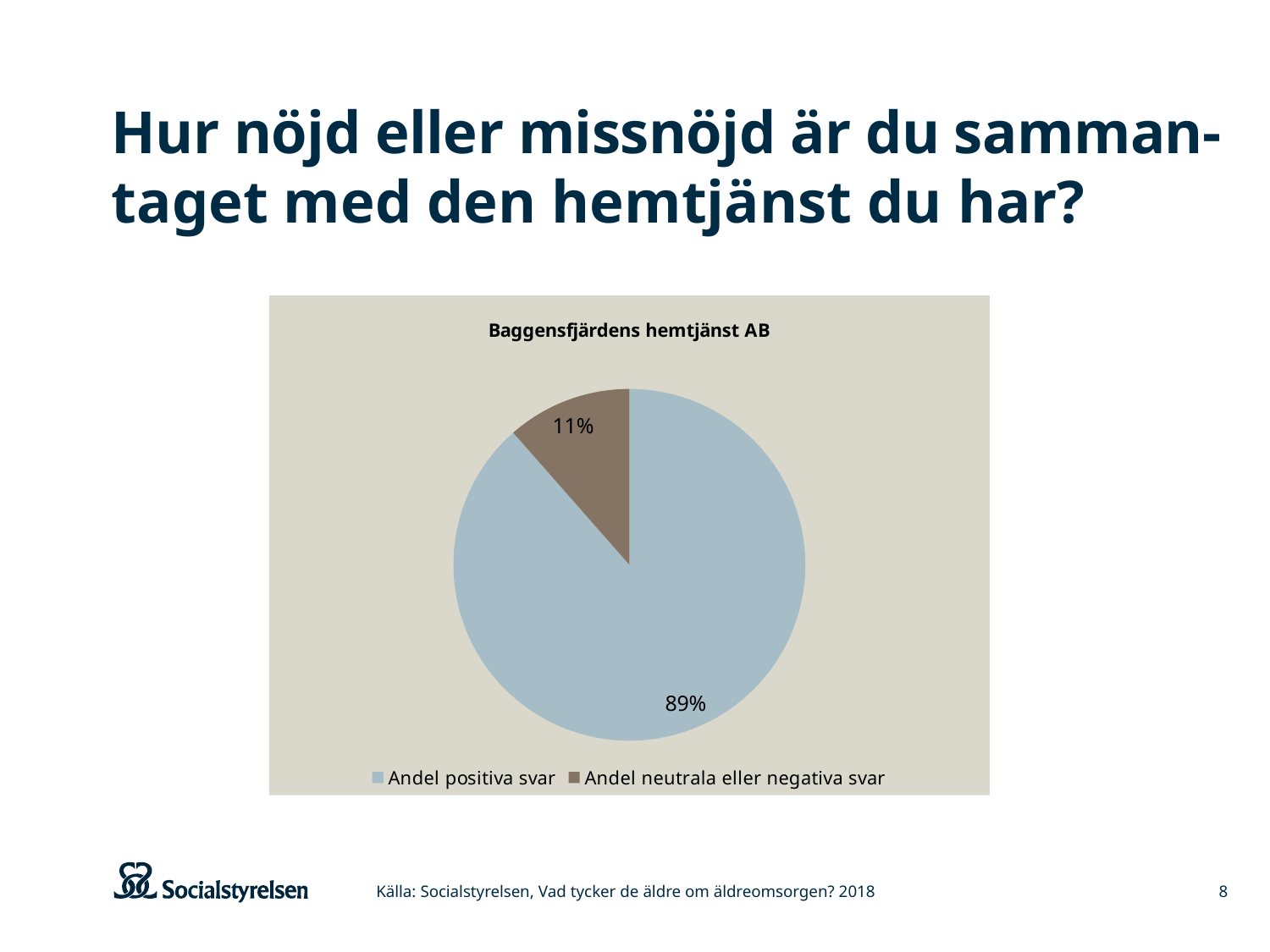
What is the title of the chart? Baggensfjärdens hemtjänst AB Which is larger, Andel positiva svar or Andel neutrala eller negativa svar? Andel positiva svar Which slice is the smallest? Andel neutrala eller negativa svar What is the value for Andel positiva svar? 89% How many slices does the pie chart have? 2 What colour is the slice for Andel positiva svar? light blue What is the value for Andel neutrala eller negativa svar? 11% What is the difference between Andel positiva svar and Andel neutrala eller negativa svar? 78% What kind of chart is shown on the slide? pie chart Which slice is the largest? Andel positiva svar How many entries does the legend list? 2 What share of the pie does Andel neutrala eller negativa svar take? 11%